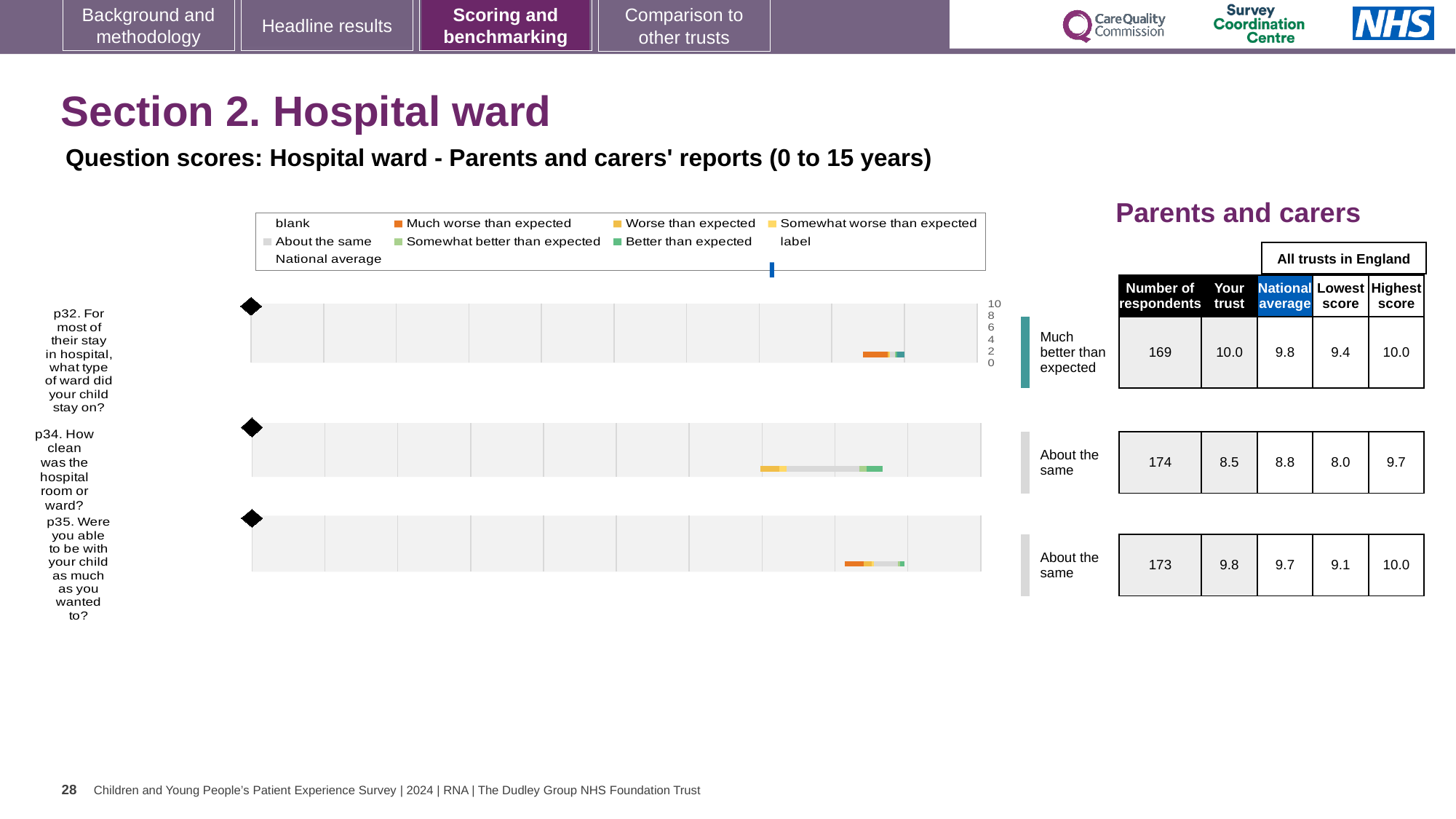
For p35, which is larger: the 'Your trust' score or the national average? Your trust What is the difference between the highest score and the lowest score for p34? 1.7 What kind of chart is used to show the question scores? Bar chart Which colour in the legend represents 'Much worse than expected'? Orange How many survey questions are plotted on the slide? 3 What is the national average score for p34 (how clean was the hospital room or ward)? 8.8 What benchmark category is shown for p32? Much better than expected How many respondents answered p34? 174 Which question has the lowest 'Your trust' score? p34 What is the 'Your trust' score for p32 (what type of ward did your child stay on)? 10.0 What is the lowest score among all trusts in England for p35 (were you able to be with your child as much as you wanted to)? 9.1 Which question has the highest 'Your trust' score? p32